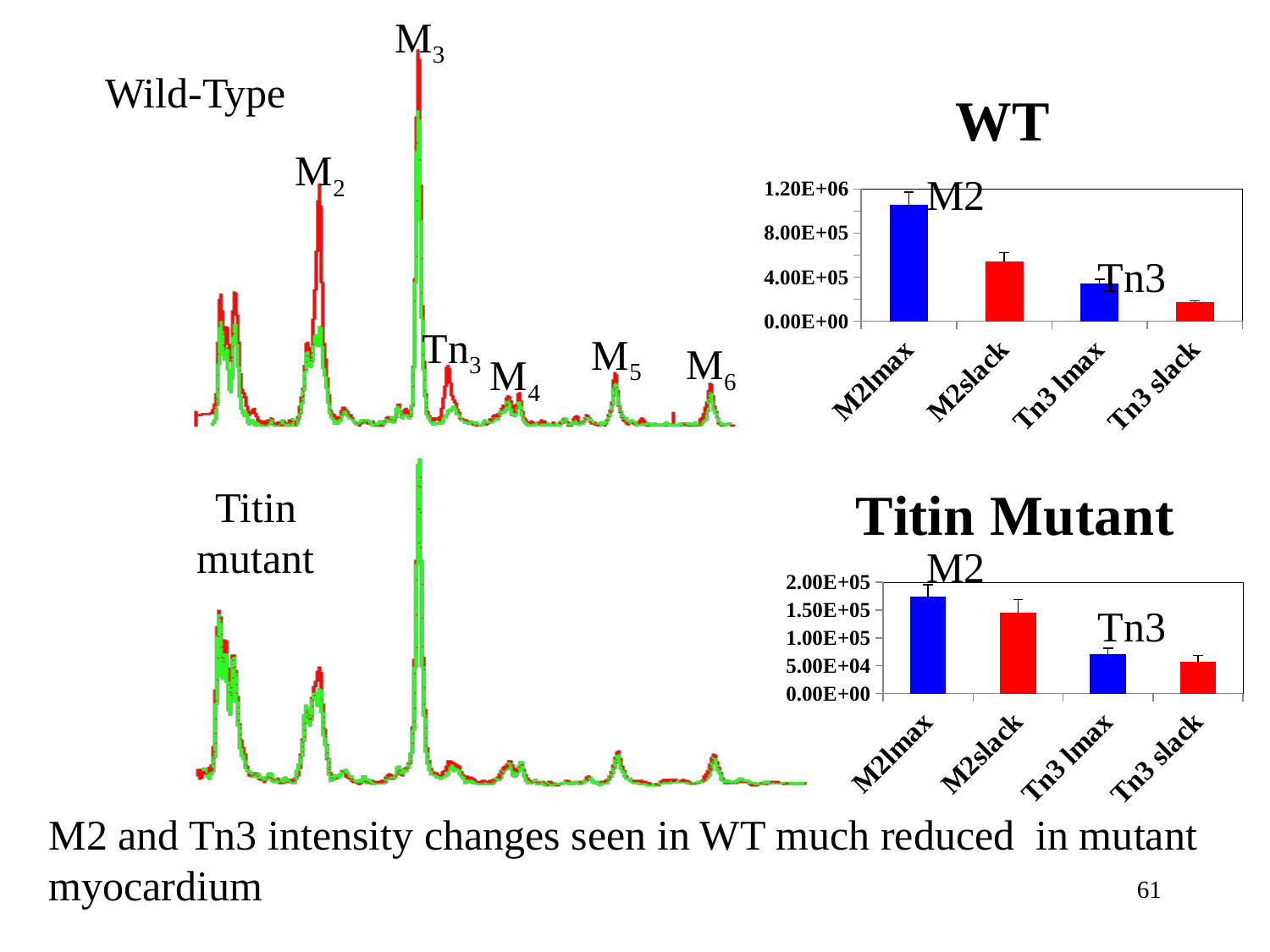
What is the title of the lower bar chart on the right side of the slide? Titin Mutant In the WT chart, which category has the lowest value? Tn3 slack In the Titin Mutant chart, is the value for Tn3 lmax greater or less than 1.00E+05? less How many categories are shown on the x axis of the Titin Mutant chart? 4 What kind of chart is the WT chart? bar chart In the Titin Mutant chart, is the value for M2lmax greater or less than 1.50E+05? greater In the Titin Mutant chart, which category has the highest value? M2lmax In the Titin Mutant chart, which category has the lowest value? Tn3 slack In the WT chart, which category has the highest value? M2lmax In the WT chart, is the value for M2lmax greater or less than 8.00E+05? greater In the WT chart, which is larger, the value for M2slack or the value for Tn3 lmax? M2slack